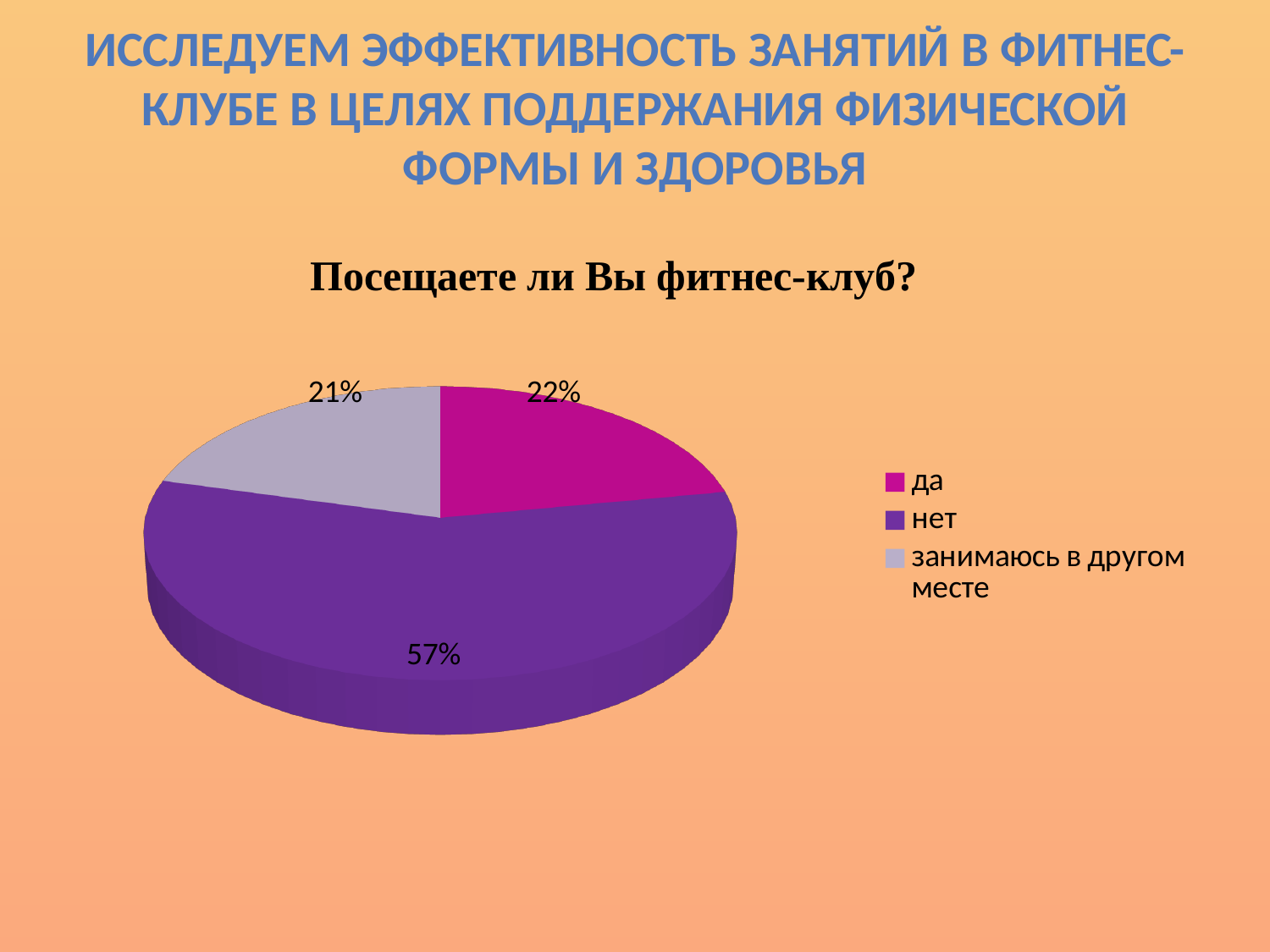
Which answer has the largest share of the pie? нет What colour is the slice for "нет"? purple What is the title of the chart? Посещаете ли Вы фитнес-клуб? How many entries does the legend list? 3 What percentage of respondents answered "нет"? 57% What percentage of respondents answered "да"? 22% What is the difference in percentage points between "нет" and "да"? 35 What kind of chart is shown on the slide? pie chart Which answer has the smallest share of the pie? занимаюсь в другом месте How many slices does the pie chart have? 3 What percentage of respondents answered "занимаюсь в другом месте"? 21% Which is larger, the share for "нет" or the share for "да"? нет